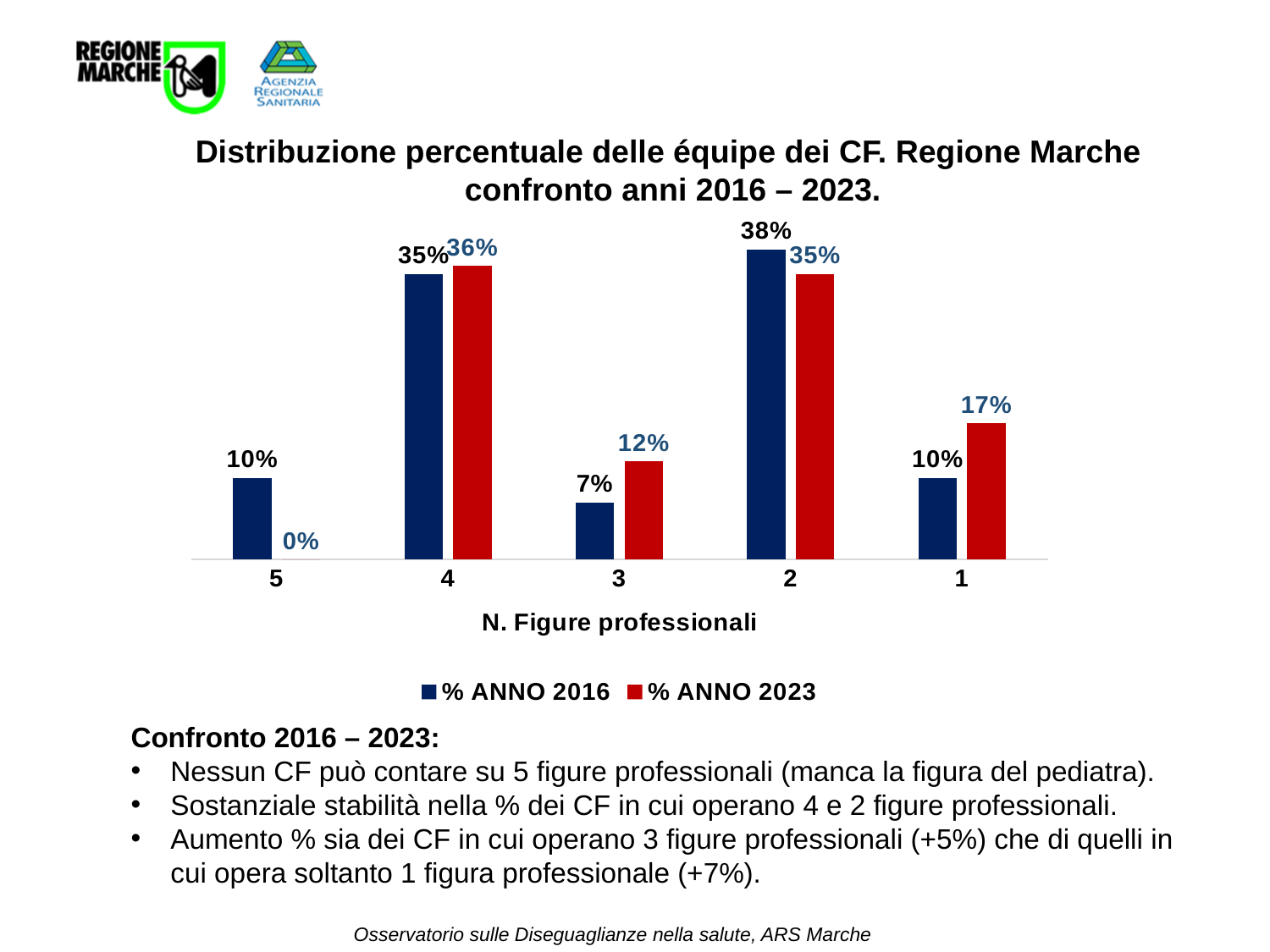
What is the value for % ANNO 2016 at 3 figure professionali? 7% How many categories are shown on the x axis? 5 What is the value for % ANNO 2023 at 5 figure professionali? 0% Which category has the highest value for % ANNO 2016? 2 What is the difference between the % ANNO 2023 and % ANNO 2016 values at 1 figura professionale? 7% What is the value for % ANNO 2016 at 2 figure professionali? 38% What is the x-axis title of the chart? N. Figure professionali What is the value for % ANNO 2023 at 1 figura professionale? 17% Which is larger at 3 figure professionali: % ANNO 2016 or % ANNO 2023? % ANNO 2023 What kind of chart is shown on the slide? Bar chart Which category has the lowest value for % ANNO 2023? 5 How many series does the legend list? 2